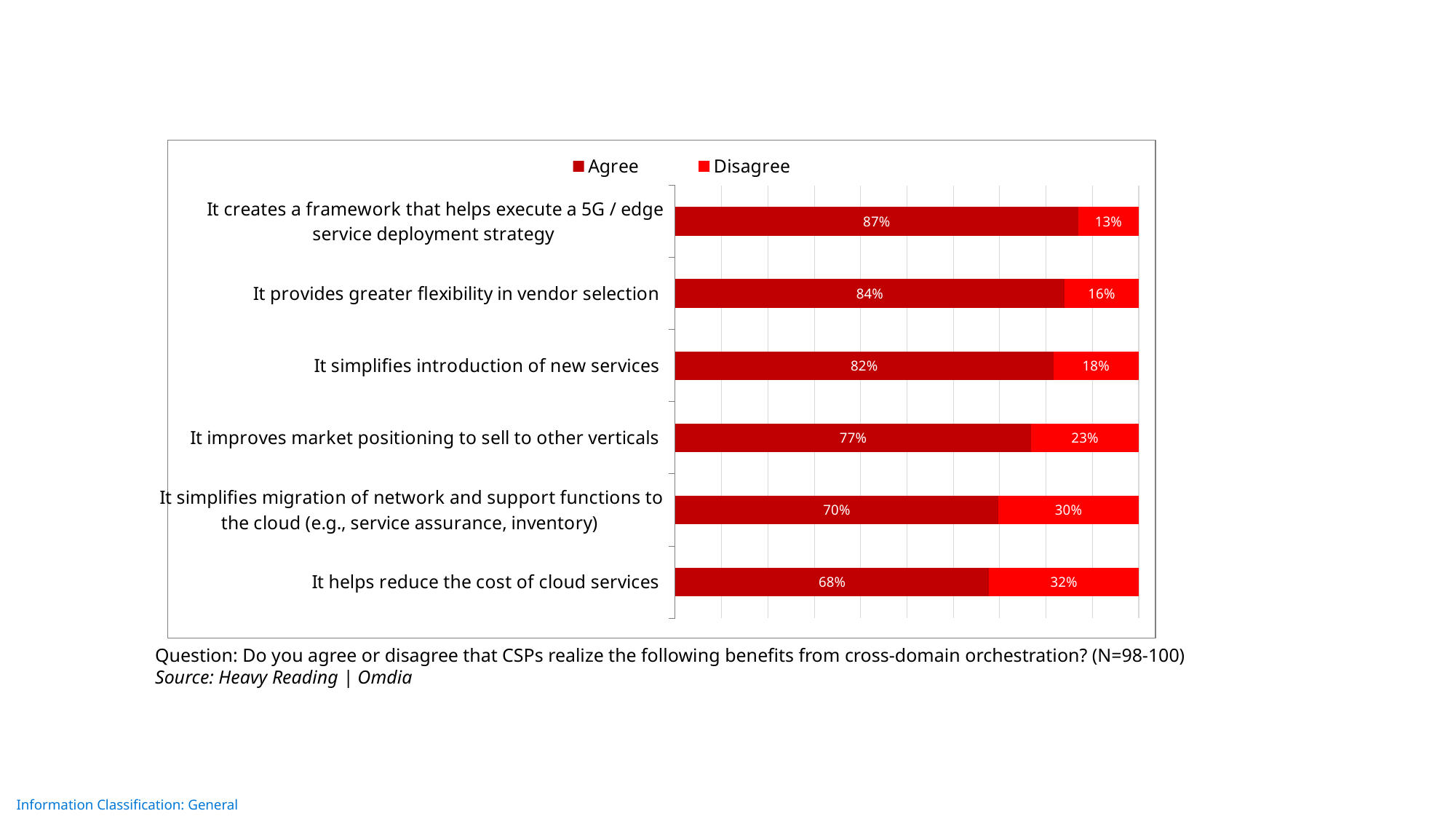
What is the Agree value for "It simplifies migration of network and support functions to the cloud (e.g., service assurance, inventory)"? 70% What is the difference between the Agree and Disagree percentages for "It improves market positioning to sell to other verticals"? 54% How many series does the legend list? 2 Which benefit has the highest Agree percentage? It creates a framework that helps execute a 5G / edge service deployment strategy What percentage of respondents agree that cross-domain orchestration provides greater flexibility in vendor selection? 84% What kind of chart is shown on the slide? Stacked bar chart How many benefit statements are shown in the chart? 6 What are the two series named in the legend? Agree and Disagree Which benefit has the lowest Agree percentage? It helps reduce the cost of cloud services Which has a larger Disagree percentage: "It simplifies introduction of new services" or "It provides greater flexibility in vendor selection"? It simplifies introduction of new services What is the Disagree value for "It helps reduce the cost of cloud services"? 32% What is the total of the Agree and Disagree segments for "It simplifies introduction of new services"? 100%